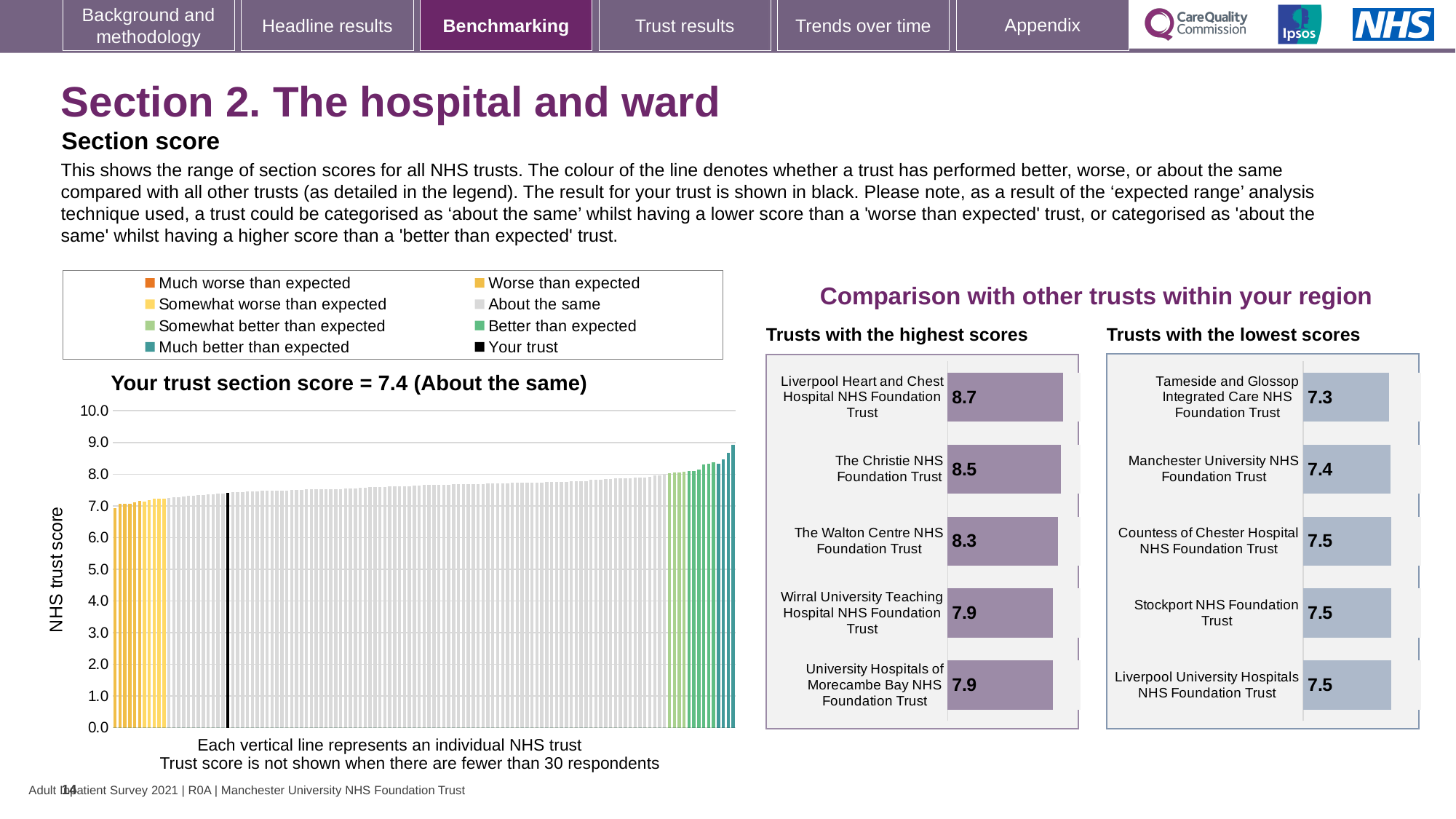
In the 'Trusts with the highest scores' chart, what is the score for The Walton Centre NHS Foundation Trust? 8.3 In the 'Trusts with the highest scores' chart, what is the difference between the scores of Liverpool Heart and Chest Hospital NHS Foundation Trust and The Walton Centre NHS Foundation Trust? 0.4 In the 'Trusts with the lowest scores' chart, which trust has the lowest score? Tameside and Glossop Integrated Care NHS Foundation Trust How many trusts are listed in the 'Trusts with the lowest scores' chart? 5 In the 'Trusts with the highest scores' chart, what is the score for Liverpool Heart and Chest Hospital NHS Foundation Trust? 8.7 In the 'Your trust section score' chart on the left, do the trust scores rise or fall from left to right? Rise In the 'Trusts with the lowest scores' chart, what is the score for Stockport NHS Foundation Trust? 7.5 In the 'Trusts with the highest scores' chart, which has the higher score: The Christie NHS Foundation Trust or The Walton Centre NHS Foundation Trust? The Christie NHS Foundation Trust What type of chart is the 'Your trust section score' chart on the left of the slide? Bar chart In the 'Trusts with the highest scores' chart, which trust has the highest score? Liverpool Heart and Chest Hospital NHS Foundation Trust How many entries does the legend above the 'Your trust section score' chart list? 8 In the 'Trusts with the lowest scores' chart, what is the score for Tameside and Glossop Integrated Care NHS Foundation Trust? 7.3